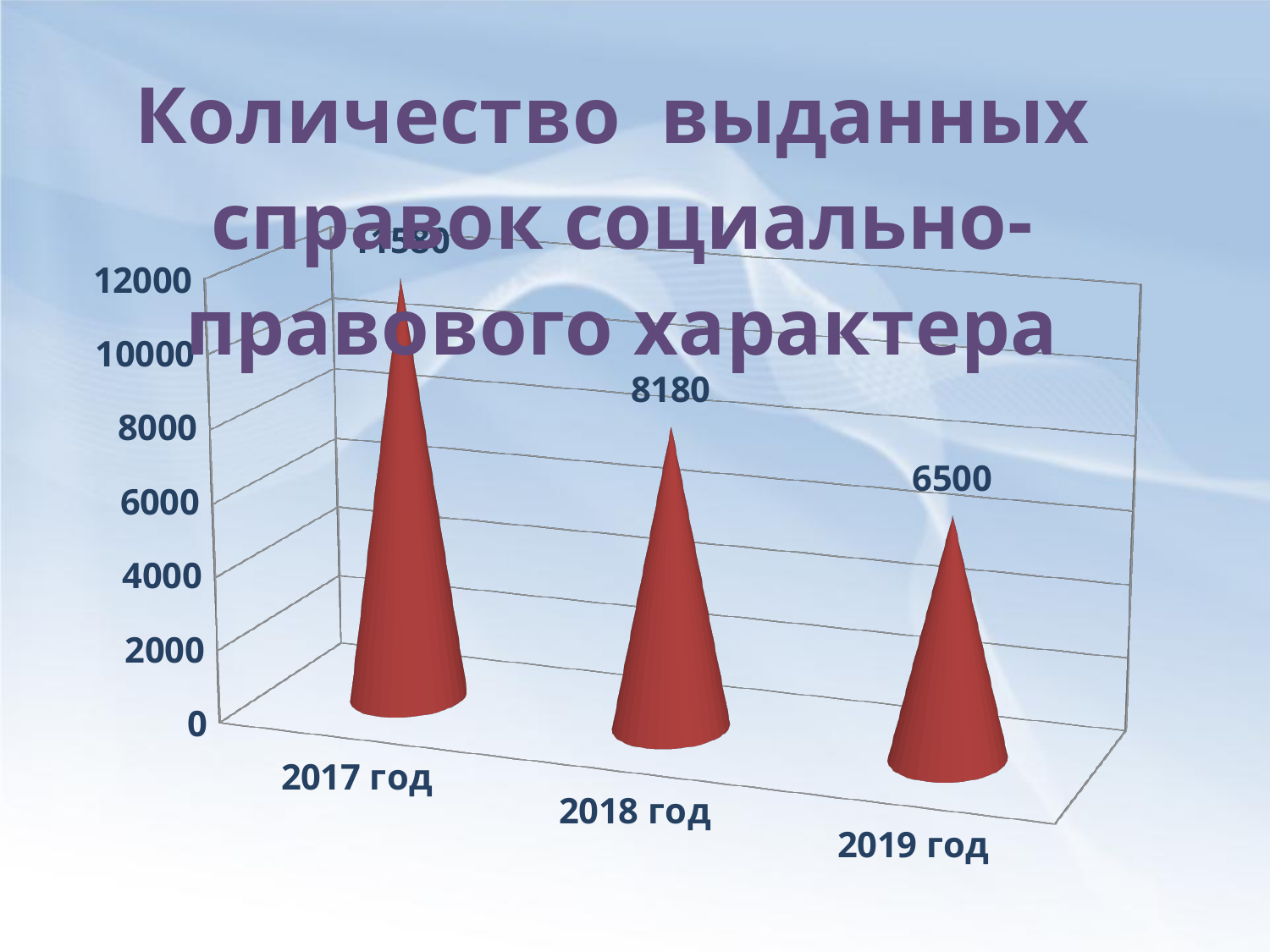
What kind of chart is shown on the slide? bar chart Do the values rise or fall from 2017 год to 2019 год? fall Is the value for 2017 год greater or less than 10000? greater Which is larger, the value for 2018 год or the value for 2019 год? 2018 год Which year has the lowest value? 2019 год How many years are shown on the x axis? 3 What is the title of the chart? Количество выданных справок социально-правового характера Which year has the highest value? 2017 год What is the value for 2018 год? 8180 What is the difference between the values for 2018 год and 2019 год? 1680 Is the value for 2019 год greater or less than 8000? less What is the value for 2019 год? 6500